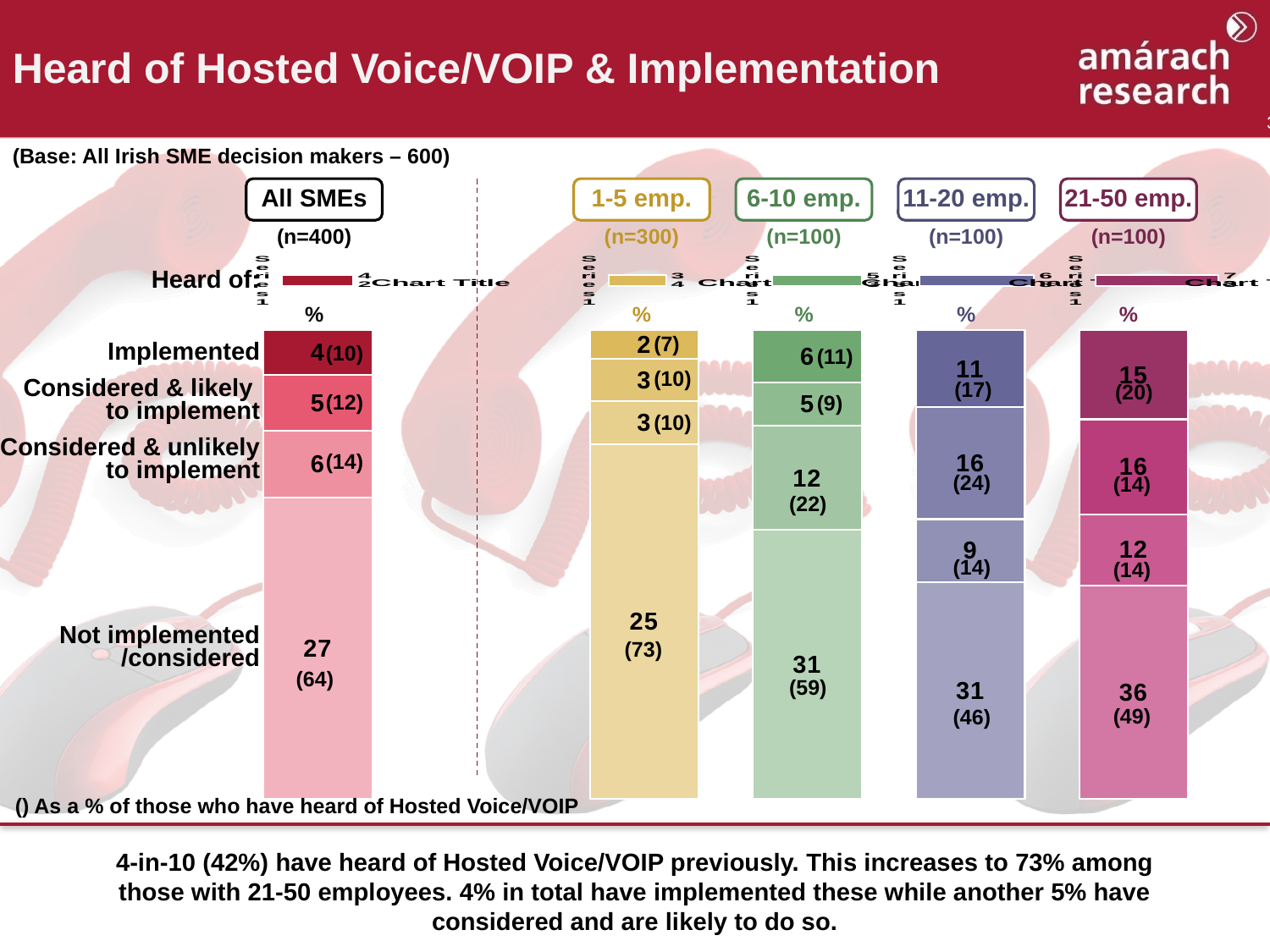
In the All SMEs chart, what is the value for Implemented? 4 In the 21-50 emp. chart, what is the value for Implemented? 15 How many segments make up the stacked bar in the 6-10 emp. chart? 4 In the 6-10 emp. chart, which category has the lowest value? Considered & likely to implement In the 11-20 emp. chart, what is the difference between Not implemented/considered and Implemented? 20 In the All SMEs chart, what is the value for Not implemented/considered? 27 In the 11-20 emp. chart, what is the value for Considered & likely to implement? 16 What kind of chart is used for the All SMEs data? Stacked bar chart In the 1-5 emp. chart, which category has the highest value? Not implemented/considered Is the Implemented value larger in the 21-50 emp. chart or the 1-5 emp. chart? 21-50 emp. What is the total of the stacked bar in the All SMEs chart? 42 In the 6-10 emp. chart, what is the value for Considered & unlikely to implement? 12